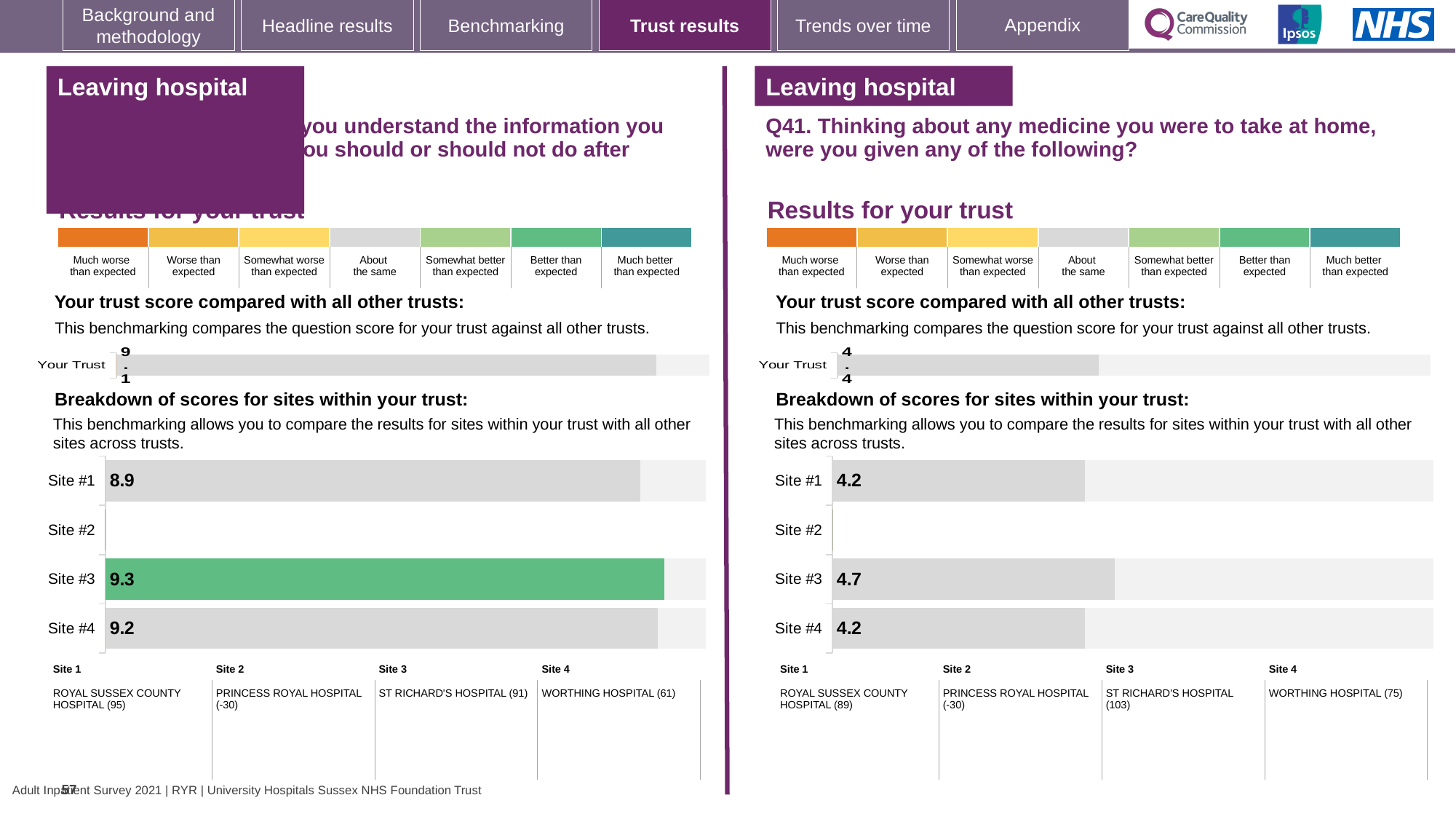
In the left chart, which site's bar is coloured green? Site #3 In the right chart (Q41), what is the difference between the scores for Site #3 and Site #4? 0.5 In the left chart (breakdown of scores for sites), what is the score for Site #3? 9.3 In the left chart, which of the labelled sites has the lowest score? Site #1 In the right chart (Q41), what is the 'Your Trust' score shown? 4.4 In the left chart, which has the higher score, Site #1 or Site #4? Site #4 In the right chart (Q41), which site has the highest score? Site #3 In the right chart (Q41 breakdown of scores for sites), what is the score for Site #1? 4.2 What type of chart is used for the breakdown of scores for sites on the right side of the slide? Bar chart In the left chart, what is the difference between the scores for Site #3 and Site #1? 0.4 In the left chart, which site has the highest score? Site #3 In the left chart, what is the 'Your Trust' score shown? 9.1